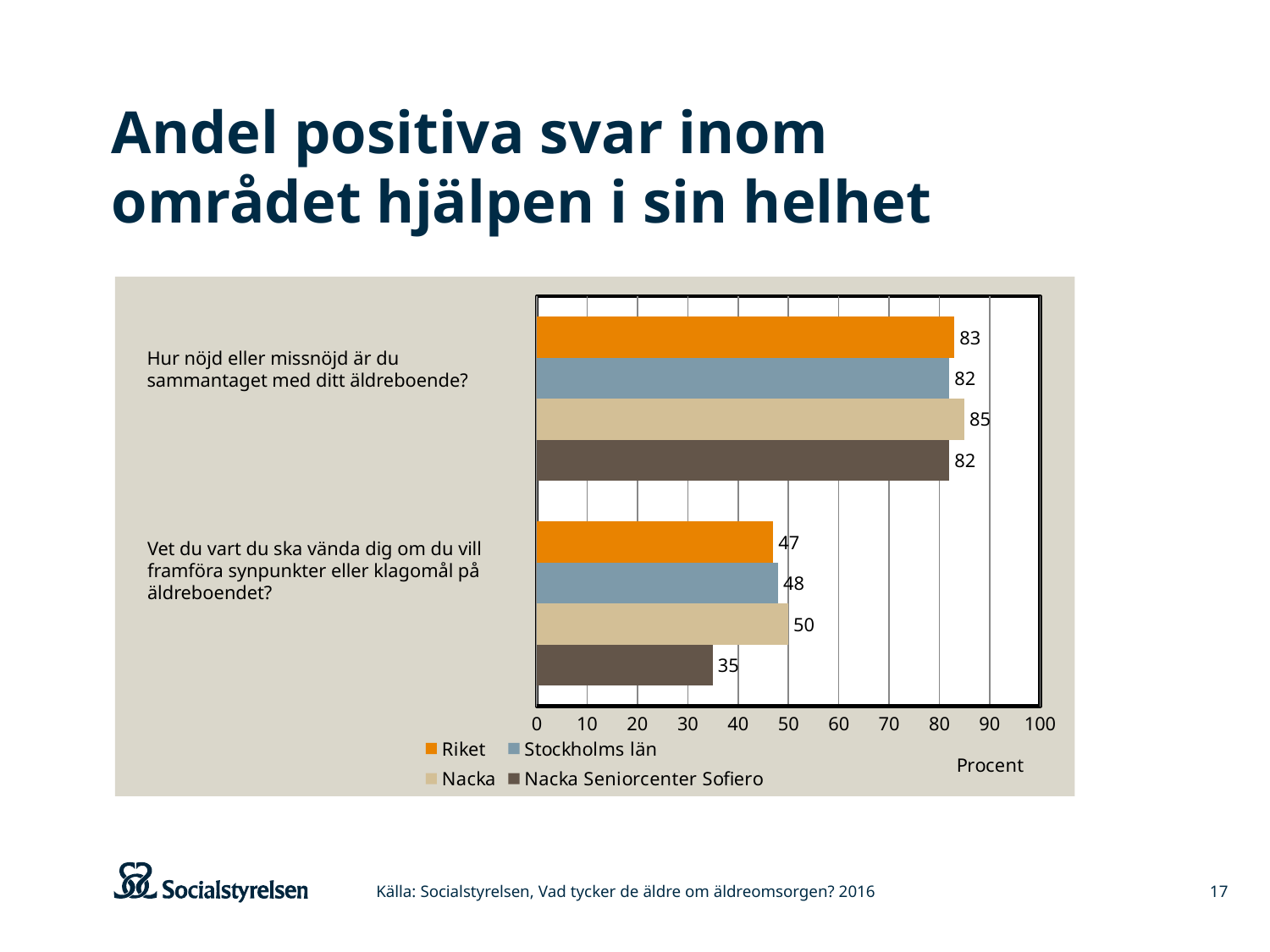
What value does Stockholms län have for the question 'Hur nöjd eller missnöjd är du sammantaget med ditt äldreboende?' 82 How many question categories are shown on the chart? 2 Which series has the lowest value for the question 'Vet du vart du ska vända dig om du vill framföra synpunkter eller klagomål på äldreboendet?' Nacka Seniorcenter Sofiero How many series does the legend list? 4 What unit is shown on the horizontal axis of the chart? Procent Which is larger for the question 'Vet du vart du ska vända dig om du vill framföra synpunkter eller klagomål på äldreboendet?': Riket or Nacka? Nacka What value does Riket have for the question 'Vet du vart du ska vända dig om du vill framföra synpunkter eller klagomål på äldreboendet?' 47 What kind of chart is shown on the slide? Bar chart What value does Nacka Seniorcenter Sofiero have for the question 'Vet du vart du ska vända dig om du vill framföra synpunkter eller klagomål på äldreboendet?' 35 Which series has the highest value for the question 'Hur nöjd eller missnöjd är du sammantaget med ditt äldreboende?' Nacka What is the difference between Nacka and Nacka Seniorcenter Sofiero for the question 'Vet du vart du ska vända dig om du vill framföra synpunkter eller klagomål på äldreboendet?' 15 What value does Nacka have for the question 'Hur nöjd eller missnöjd är du sammantaget med ditt äldreboende?' 85